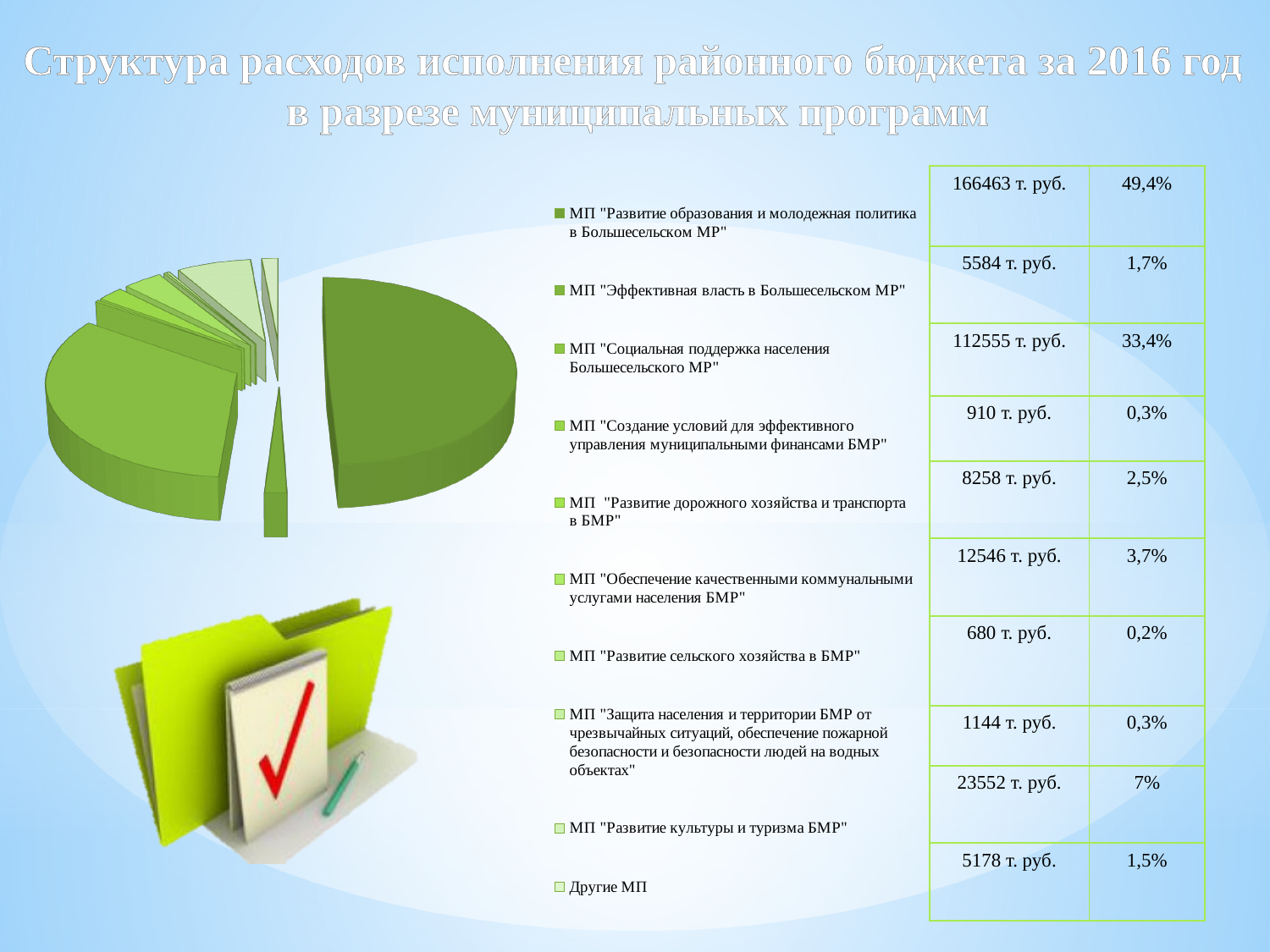
What percentage share is shown for Другие МП? 1,5% Which municipal programme has the smallest share of expenditure in the pie chart? МП "Развитие сельского хозяйства в БМР" Which is larger: the expenditure for МП "Эффективная власть в Большесельском МР" or for МП "Развитие дорожного хозяйства и транспорта в БМР"? МП "Развитие дорожного хозяйства и транспорта в БМР" How many categories does the pie chart's legend list? 10 What kind of chart is shown on the slide? pie chart What share of the pie does МП "Социальная поддержка населения Большесельского МР" account for? 33,4% Which municipal programme has the largest share of expenditure in the pie chart? МП "Развитие образования и молодежная политика в Большесельском МР" What is the difference in expenditure between МП "Развитие образования и молодежная политика в Большесельском МР" and МП "Социальная поддержка населения Большесельского МР"? 53908 т. руб. What is the expenditure value shown for МП "Обеспечение качественными коммунальными услугами населения БМР"? 12546 т. руб. What is the difference in percentage share between МП "Развитие культуры и туризма БМР" and МП "Обеспечение качественными коммунальными услугами населения БМР"? 3,3% What is the title of the slide containing the pie chart? Структура расходов исполнения районного бюджета за 2016 год в разрезе муниципальных программ What is the expenditure value shown for МП "Развитие культуры и туризма БМР"? 23552 т. руб.